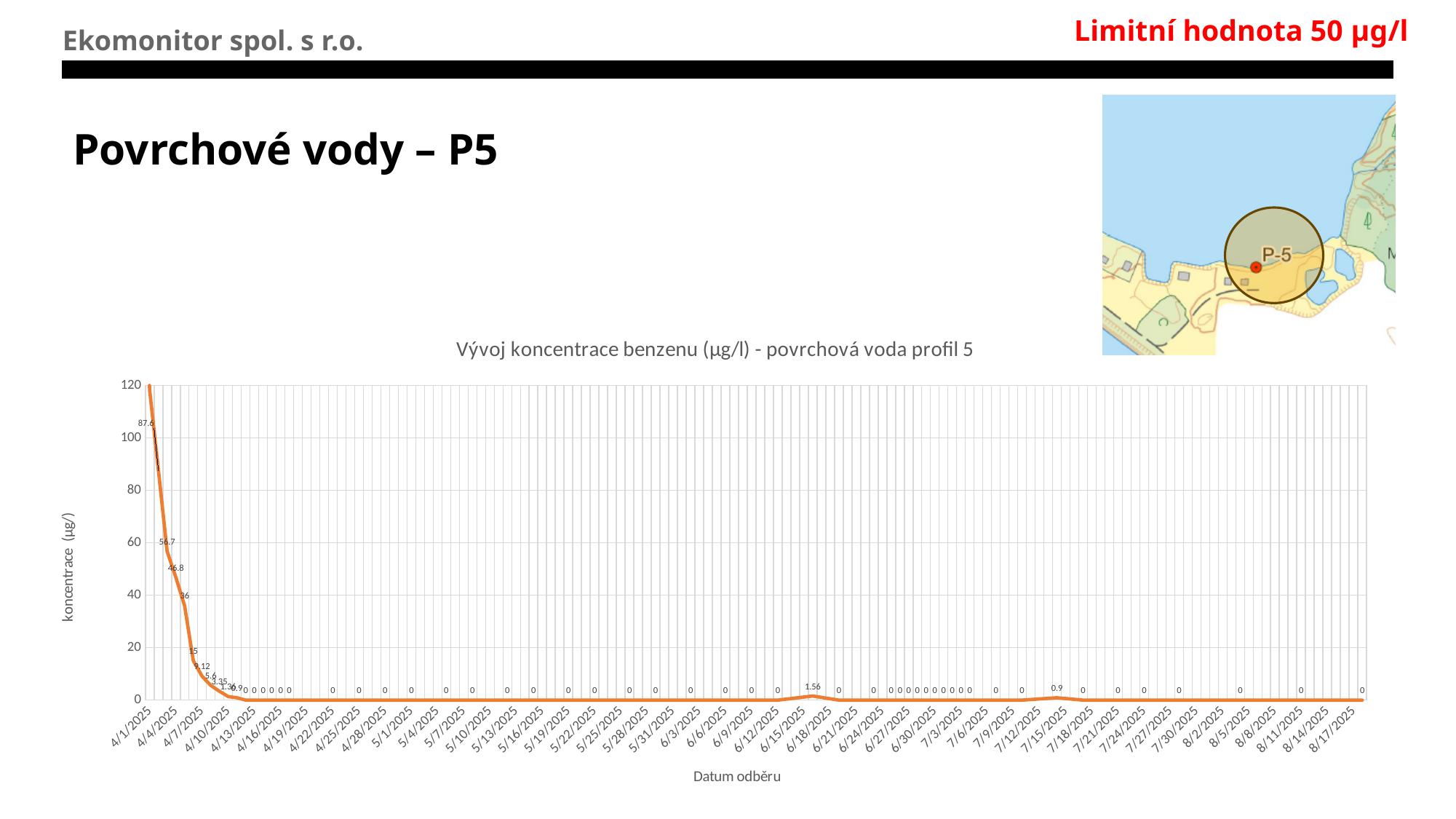
What kind of chart is shown on the slide? line chart What is the highest tick value shown on the y axis? 120 Is the value for 6/15/2025 greater or less than 20? less Which is larger, the value for 4/1/2025 or the value for 4/13/2025? 4/1/2025 Do the benzene concentration values generally rise or fall along the x axis? fall On which date is the benzene concentration highest? 4/1/2025 What is the value for 5/1/2025? 0 What is the title of the chart? Vývoj koncentrace benzenu (µg/l) - povrchová voda profil 5 Is the value for 4/7/2025 greater or less than 20? less What is the label of the x axis of the chart? Datum odběru Is the value for 4/1/2025 greater or less than 100? greater